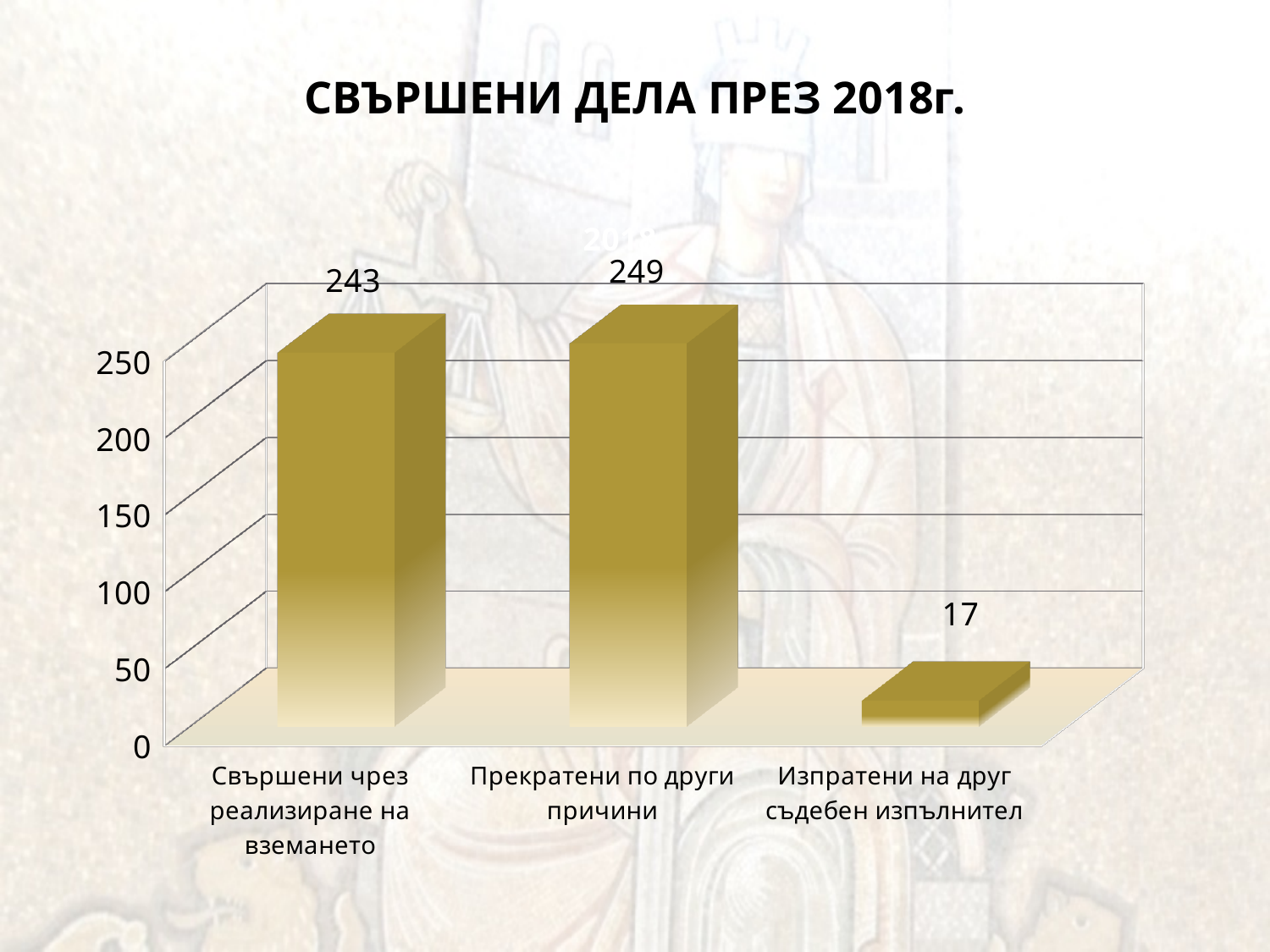
What kind of chart is shown on the slide? bar chart Which category has the highest value? Прекратени по други причини What is the title of the slide? СВЪРШЕНИ ДЕЛА ПРЕЗ 2018г. What is the value for "Свършени чрез реализиране на вземането"? 243 What is the difference between the values for "Прекратени по други причини" and "Свършени чрез реализиране на вземането"? 6 Which is larger: the value for "Свършени чрез реализиране на вземането" or the value for "Изпратени на друг съдебен изпълнител"? Свършени чрез реализиране на вземането Which category has the lowest value? Изпратени на друг съдебен изпълнител How many categories are shown in the chart? 3 What is the value for "Прекратени по други причини"? 249 What is the value for "Изпратени на друг съдебен изпълнител"? 17 Is the value for "Изпратени на друг съдебен изпълнител" greater or less than 50? less What is the difference between the values for "Свършени чрез реализиране на вземането" and "Изпратени на друг съдебен изпълнител"? 226